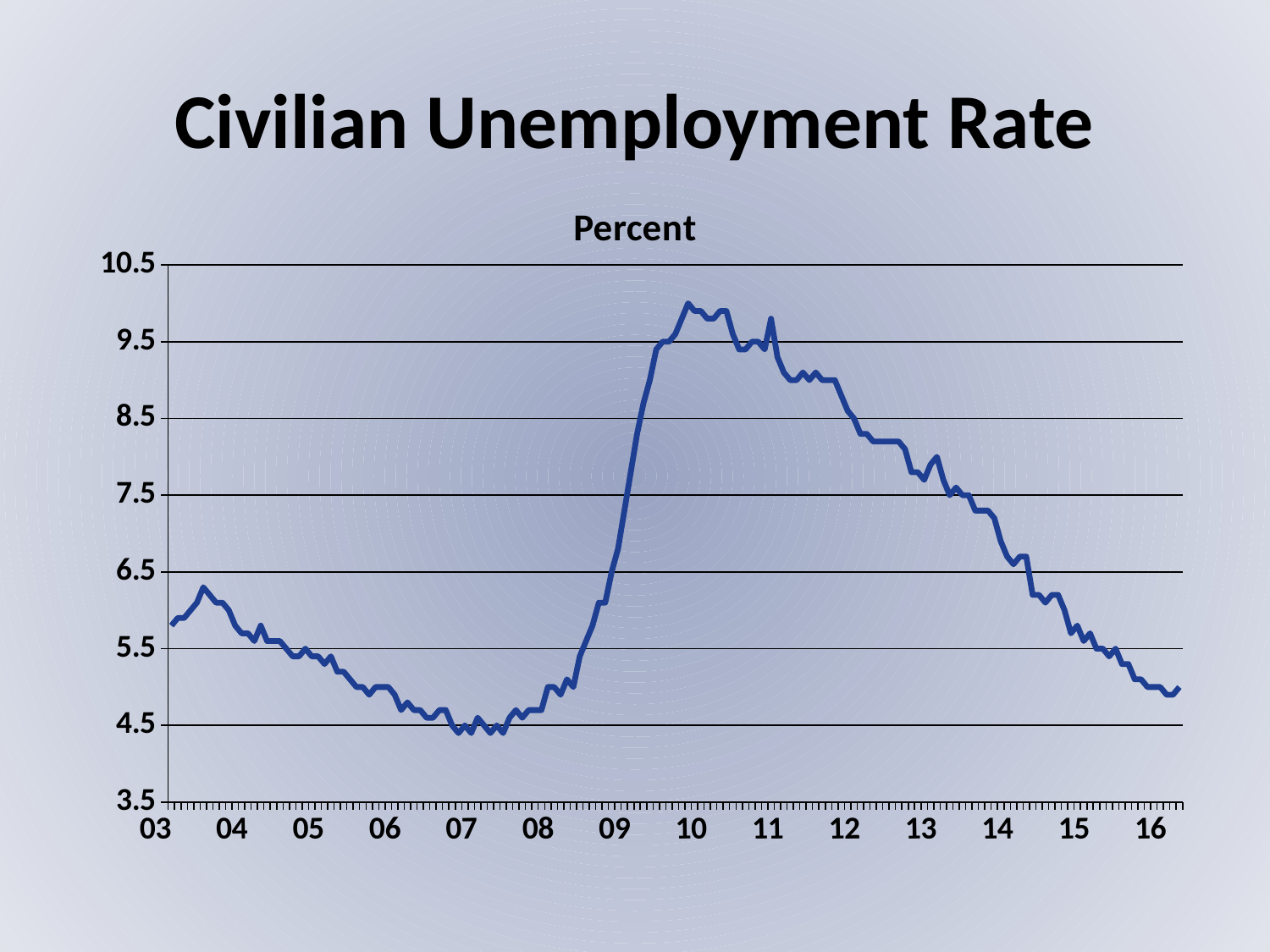
Is the unemployment rate at the 14 mark on the x axis greater or less than 7.5? less What kind of chart is shown on the slide? line chart Is the unemployment rate at the 10 mark on the x axis greater or less than 9.5? greater Does the unemployment rate rise or fall between the 11 and 16 marks on the x axis? fall How many year labels are shown along the x axis? 14 Is the unemployment rate at the 13 mark on the x axis greater or less than 7.5? greater What unit is the vertical axis labelled with? Percent What is the title of the chart? Civilian Unemployment Rate Around which year label on the x axis does the unemployment rate reach its highest point? 10 Does the unemployment rate rise or fall between the 09 and 10 marks on the x axis? rise